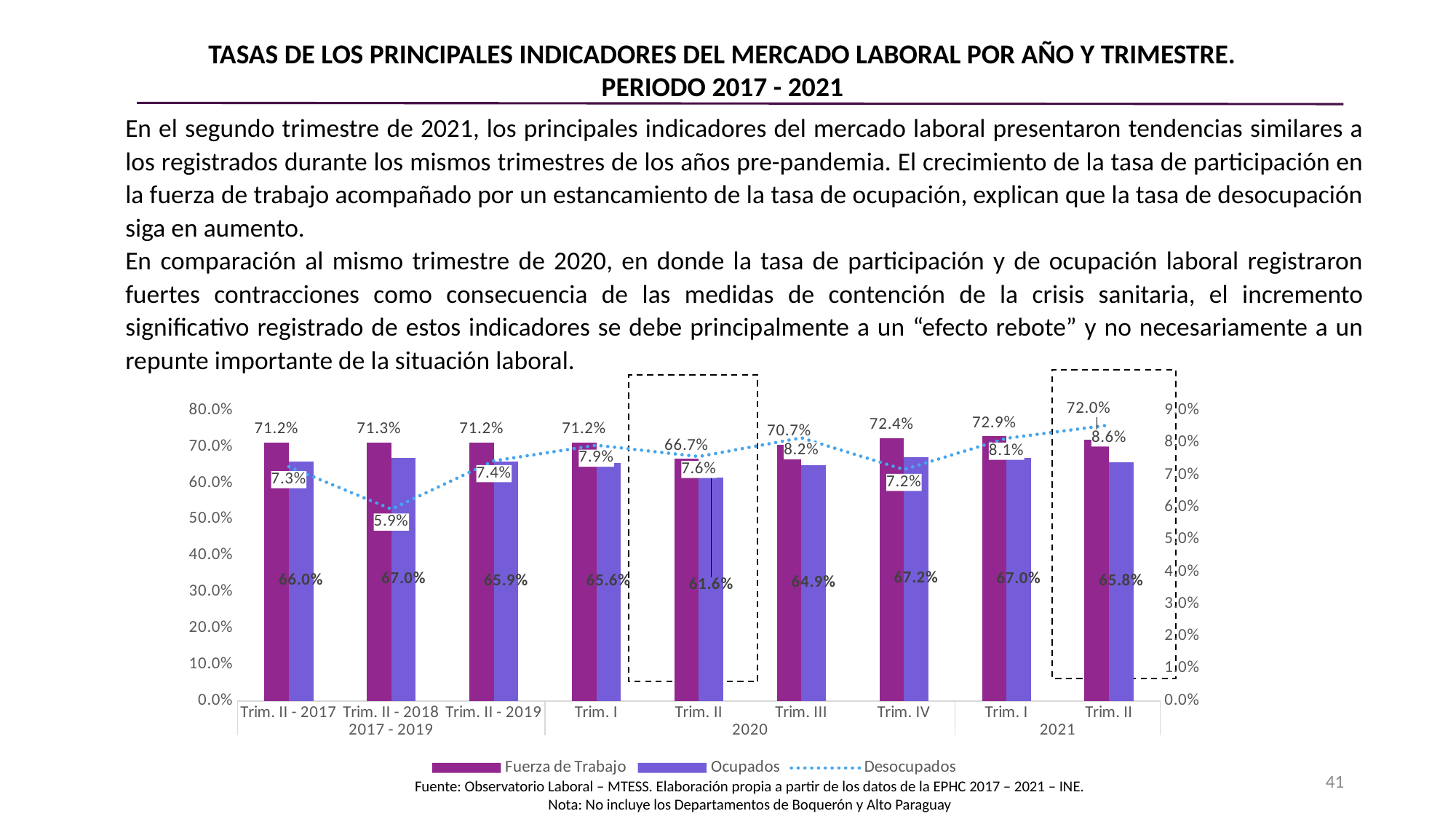
Which period has the lowest Ocupados value? Trim. II 2020 What kind of chart is this? Combined bar and line chart Which period has the highest Fuerza de Trabajo value? Trim. I 2021 What is the Ocupados value for Trim. II of 2020? 61.6% How many periods (categories) are shown on the x axis? 9 What is the Desocupados value for Trim. II of 2021? 8.6% What is the difference in Fuerza de Trabajo between Trim. II of 2021 and Trim. II of 2020? 5.3 percentage points Which period has the lowest Desocupados value? Trim. II - 2018 Which is larger, the Ocupados value for Trim. II - 2017 or for Trim. II of 2020? Trim. II - 2017 Which series is plotted as a dotted line? Desocupados How many series does the legend list? 3 What is the Fuerza de Trabajo value for Trim. II - 2018? 71.3%